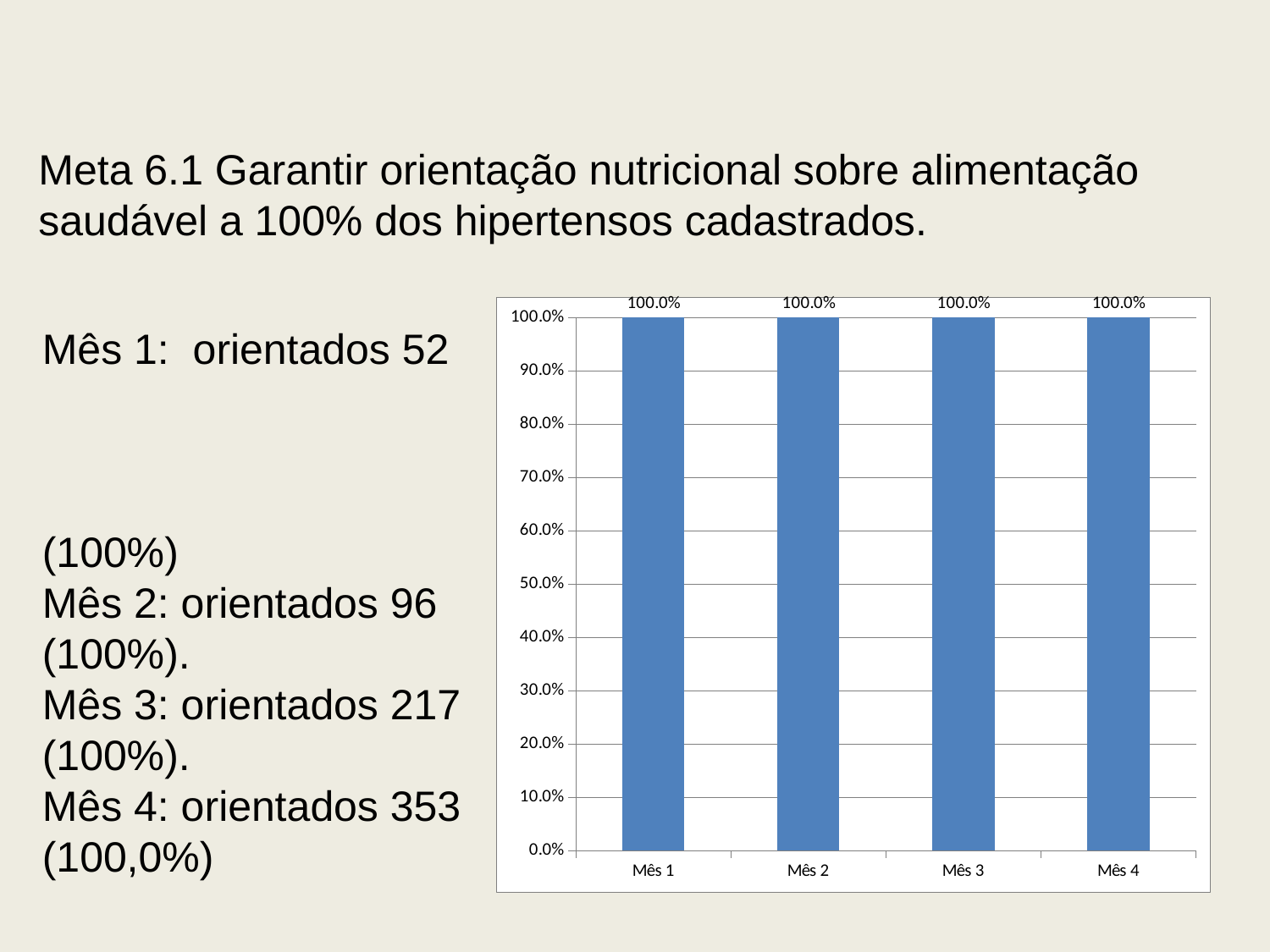
What is the label of the first category on the x axis? Mês 1 What is the value shown for Mês 1? 100.0% What is the highest tick value shown on the y axis? 100.0% What is the value shown for Mês 2? 100.0% What is the difference between the values for Mês 1 and Mês 4? 0.0% How many categories are plotted on the x axis of the chart? 4 What kind of chart is shown on the slide? bar chart Is the value for Mês 3 greater or less than 90.0%? greater What is the value shown for Mês 3? 100.0% What is the value shown for Mês 4? 100.0% Do the values rise, fall, or stay the same from Mês 1 to Mês 4? stay the same